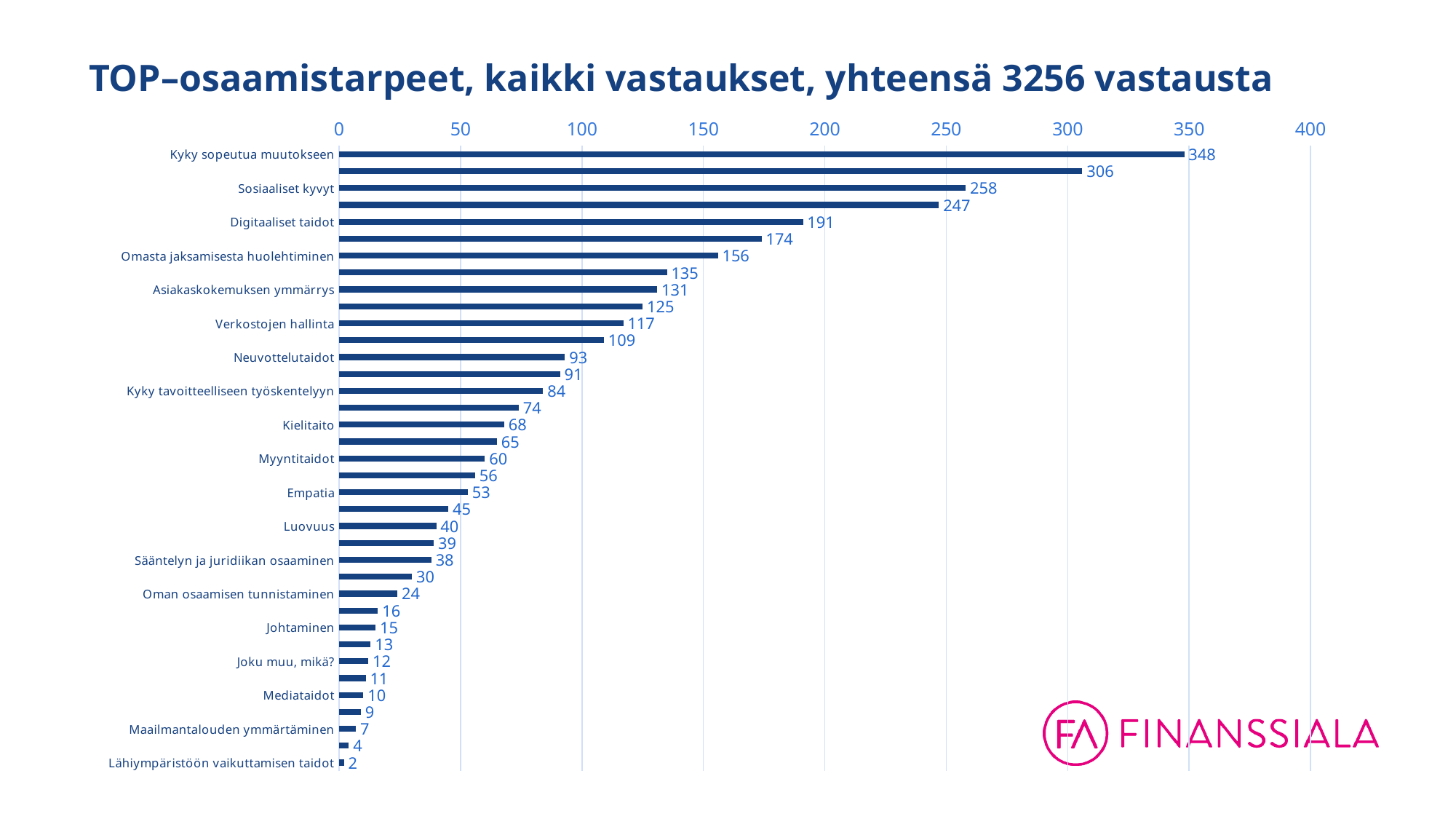
What is the difference between the values for Kyky sopeutua muutokseen and Sosiaaliset kyvyt? 90 What is the title of the chart? TOP-osaamistarpeet, kaikki vastaukset, yhteensä 3256 vastausta Which is larger, the value for Kielitaito or the value for Myyntitaidot? Kielitaito Which category has the highest value? Kyky sopeutua muutokseen What is the value for Empatia? 53 What is the value for Mediataidot? 10 What kind of chart is shown on the slide? bar chart What is the value for Kyky sopeutua muutokseen? 348 Which category has the lowest value? Lähiympäristöön vaikuttamisen taidot Is the value for Omasta jaksamisesta huolehtiminen greater or less than 150? greater What is the value for Neuvottelutaidot? 93 What is the value for Digitaaliset taidot? 191